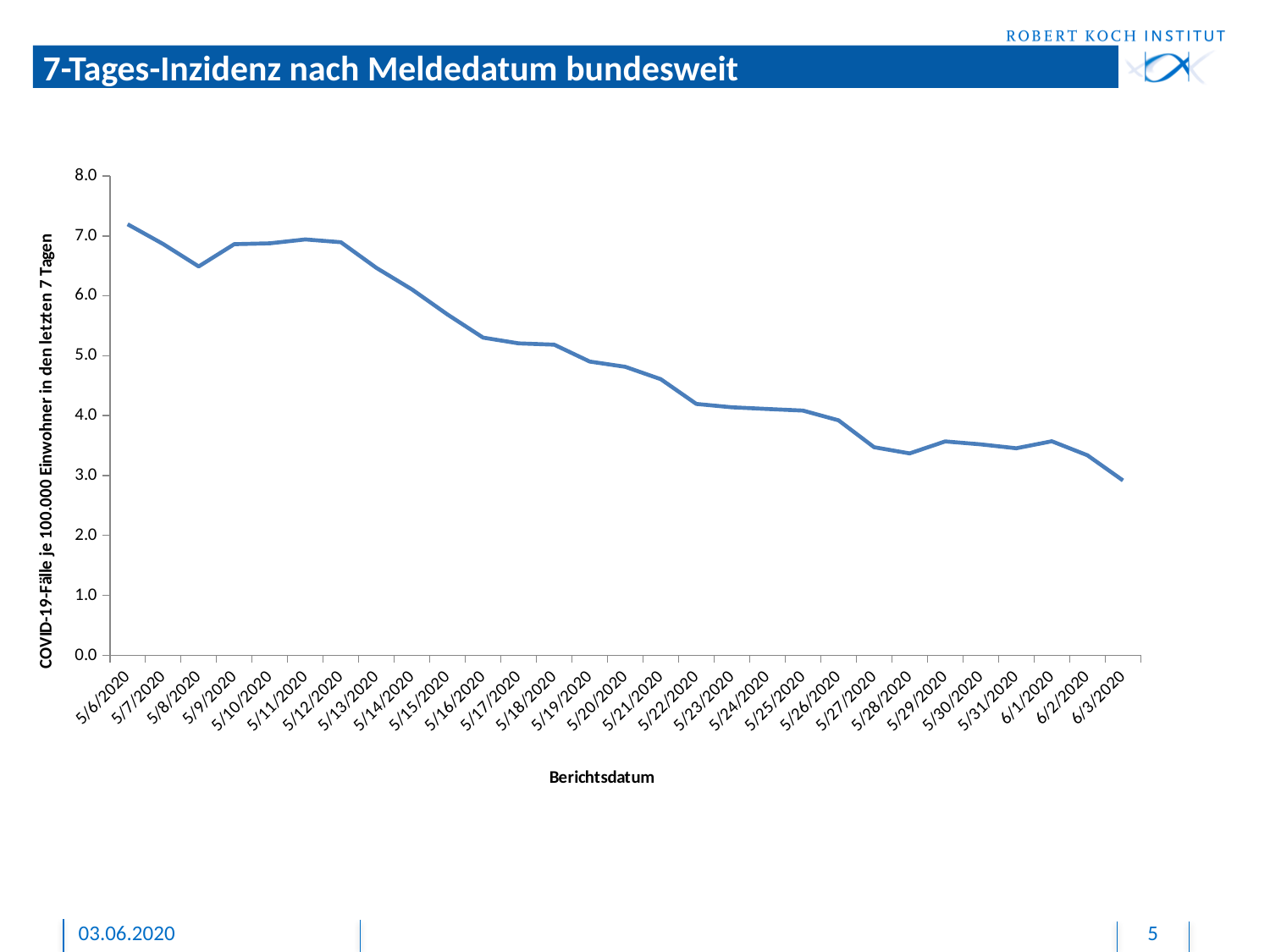
On which date is the 7-day incidence highest? 5/6/2020 Is the value for 5/28/2020 greater or less than 4.0? less Is the value for 5/22/2020 greater or less than 4.0? greater On which date is the 7-day incidence lowest? 6/3/2020 Is the value for 5/6/2020 greater or less than 7.0? greater What is the label of the x axis? Berichtsdatum How many dates are plotted along the x axis? 29 Do the values generally rise or fall from 5/6/2020 to 6/3/2020? fall What kind of chart is shown on the slide? line chart Which date has the larger value, 5/6/2020 or 6/3/2020? 5/6/2020 What is the title of the chart? 7-Tages-Inzidenz nach Meldedatum bundesweit